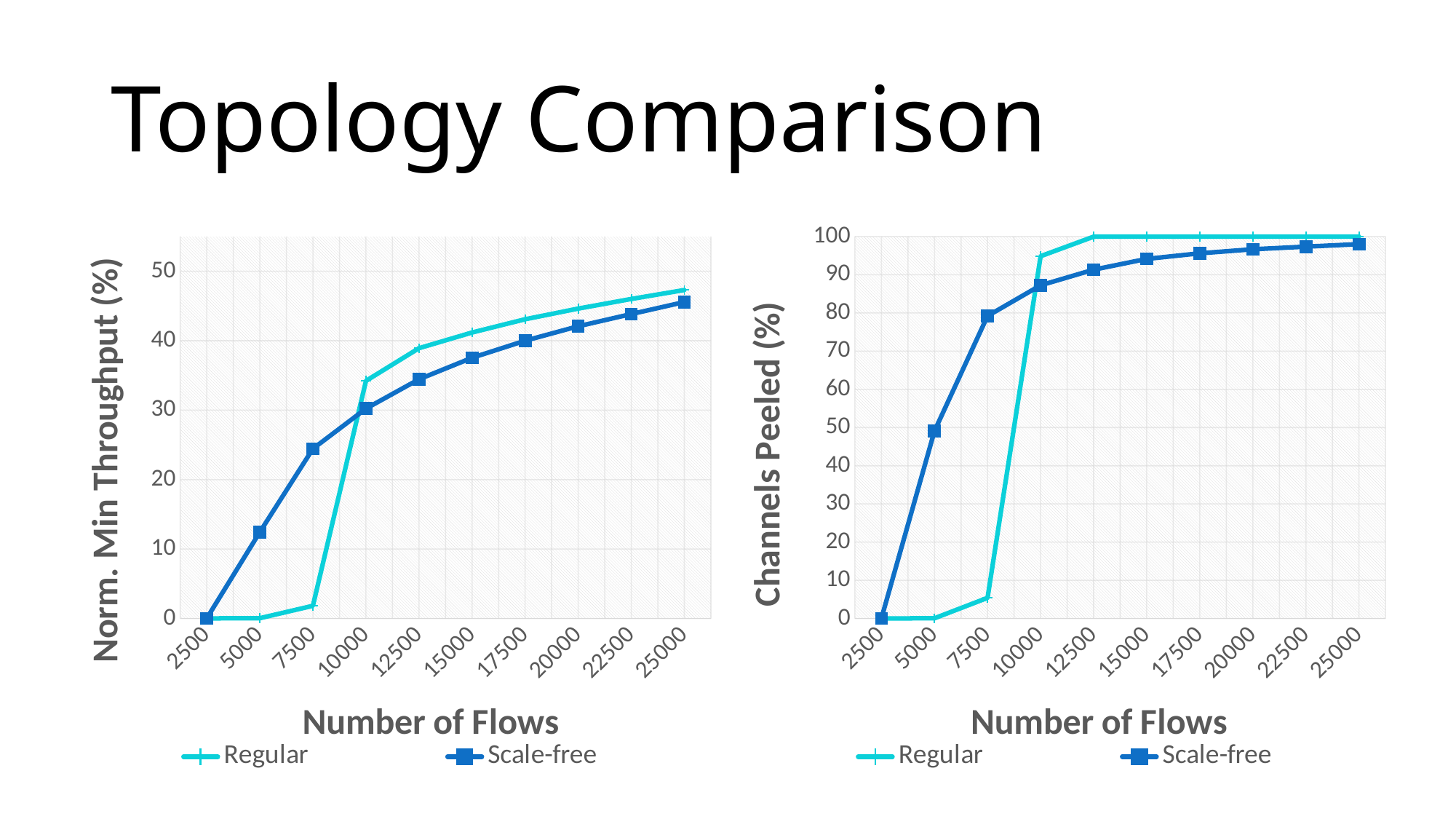
On the left chart, Norm. Min Throughput (%), is the Regular value at 7500 flows greater or less than 10? less On the left chart, Norm. Min Throughput (%), which series has the larger value at 15000 flows, Regular or Scale-free? Regular On the left chart, Norm. Min Throughput (%), which series has the larger value at 7500 flows, Regular or Scale-free? Scale-free How many x-axis points (Number of Flows values) are plotted on the left chart, Norm. Min Throughput (%)? 10 On the right chart, Channels Peeled (%), do the Scale-free values rise or fall as the Number of Flows increases? rise What kind of chart is the left chart, Norm. Min Throughput (%)? line chart What is the x-axis title of the left chart, Norm. Min Throughput (%)? Number of Flows On the right chart, Channels Peeled (%), is the Scale-free value at 7500 flows greater or less than 70? greater On the right chart, Channels Peeled (%), is the Regular value at 7500 flows greater or less than 10? less On the right chart, Channels Peeled (%), which series has the larger value at 5000 flows, Regular or Scale-free? Scale-free How many series does the legend of the right chart, Channels Peeled (%), list? 2